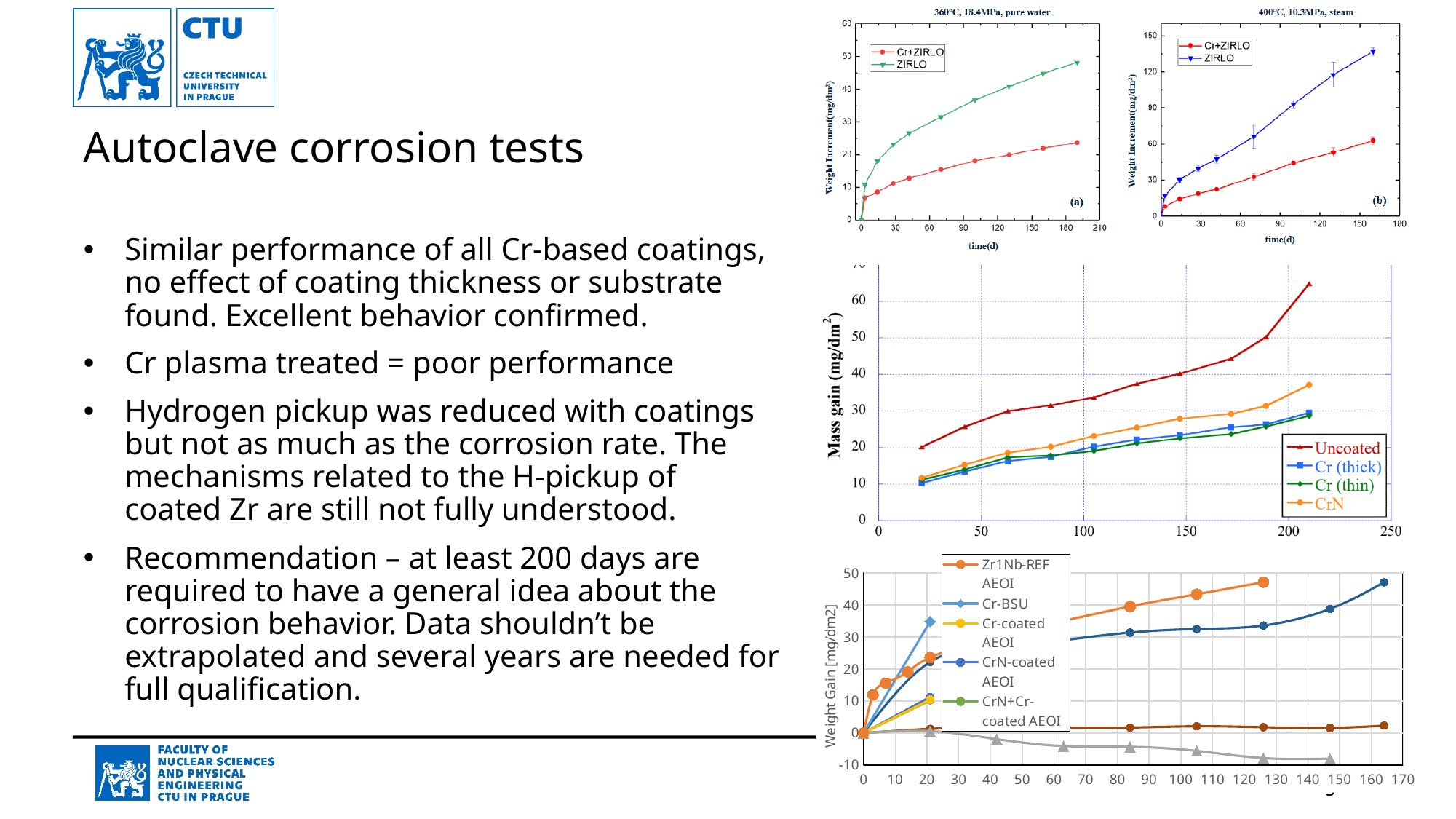
In the bottom chart (Weight Gain), is the value for Zr1Nb-REF AEOI at about 125 days greater or less than 40? greater What is the y-axis label of the bottom chart? Weight Gain [mg/dm2] In the top-left chart (360°C, 18.4MPa, pure water), which series has the higher weight increment at 180 days, Cr+ZIRLO or ZIRLO? ZIRLO How many series does the legend of the top-left chart (360°C, 18.4MPa, pure water) list? 2 In the middle chart (Mass gain), does the Uncoated series rise or fall along the x axis? rise What is the y-axis label of the middle chart? Mass gain (mg/dm2) How many series does the legend of the middle chart (Mass gain) list? 4 In the middle chart (Mass gain), which series has the highest mass gain at the end of the test? Uncoated In the middle chart (Mass gain), is the final mass gain of the Uncoated series greater or less than 60? greater What kind of chart is the top-left chart titled '360°C, 18.4MPa, pure water'? line chart In the top-right chart (400°C, 10.3MPa, steam), is the weight increment for ZIRLO at 160 days greater or less than 120? greater